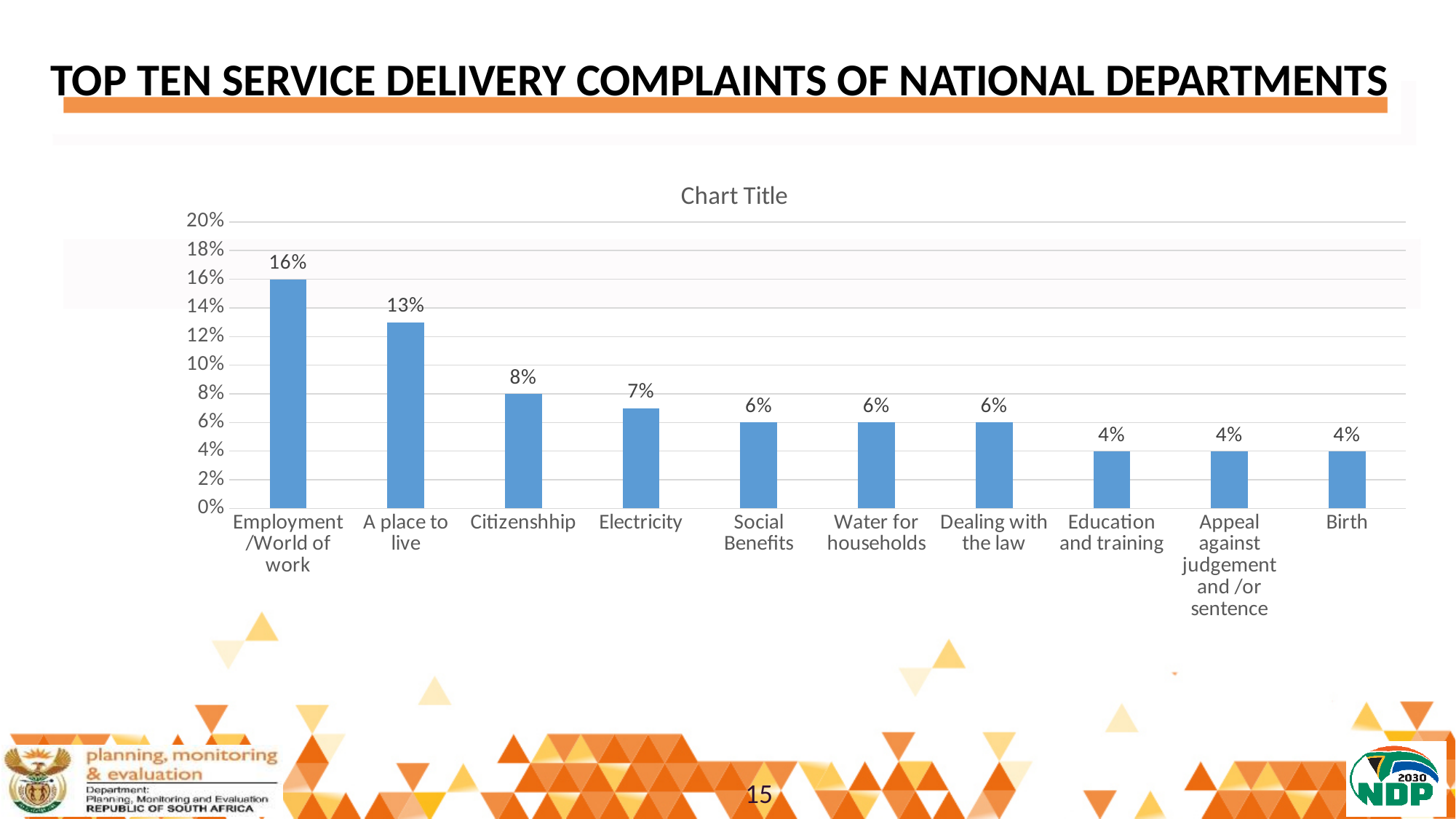
Do the values rise or fall from left to right along the x axis? fall What is the difference between the values for Employment/World of work and A place to live? 3% Is the value for A place to live greater or less than 10%? greater Which category has the highest value? Employment/World of work What is the difference between the values for Citizenshhip and Education and training? 4% What is the value for Birth? 4% What is the value for A place to live? 13% How many categories are shown on the x axis? 10 What kind of chart is shown on the slide? bar chart Which is larger, the value for Citizenshhip or the value for Electricity? Citizenshhip What is the value for Employment/World of work? 16% What is the value for Electricity? 7%